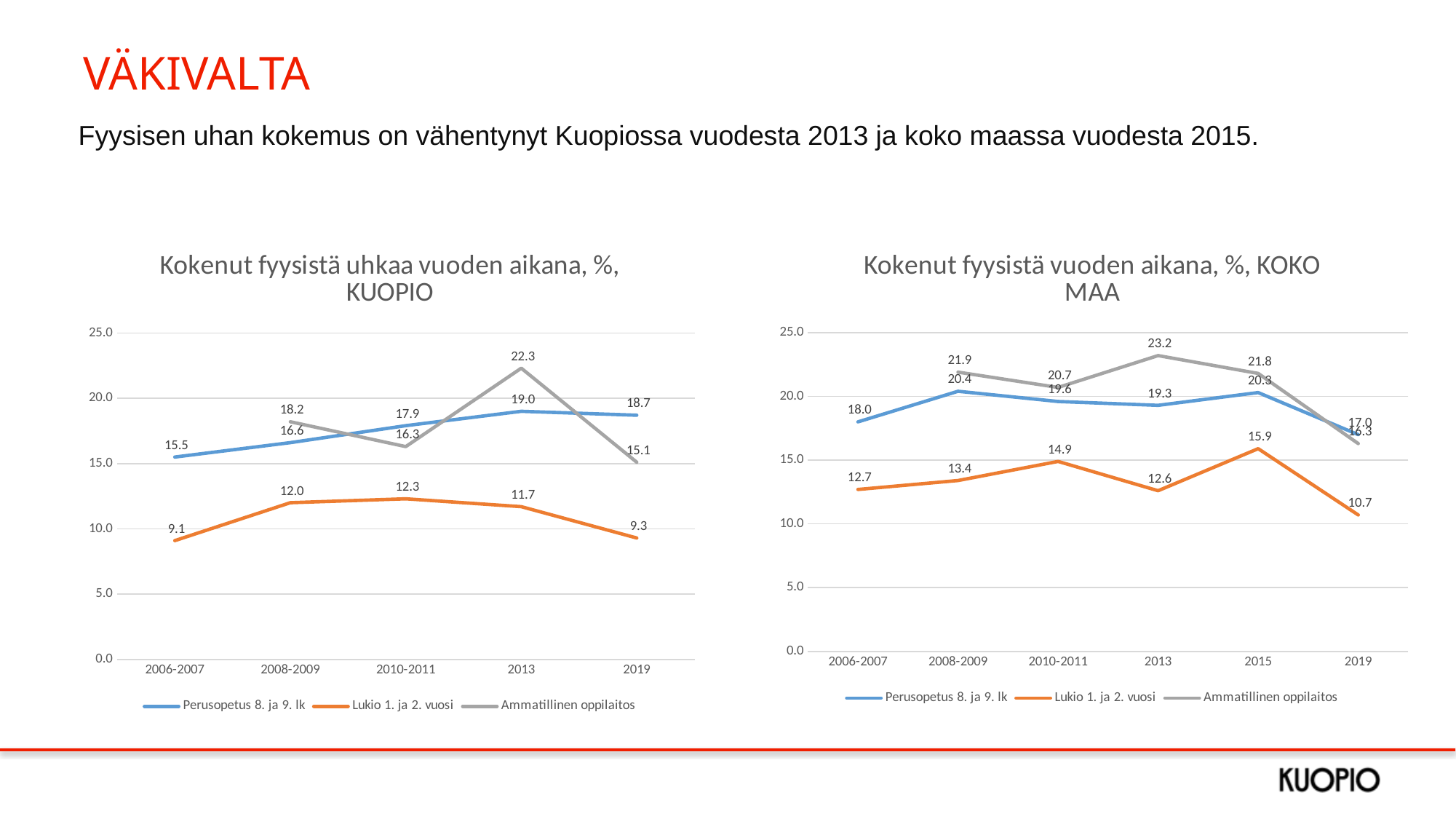
In the KUOPIO chart, what is the value for Ammatillinen oppilaitos in 2019? 15.1 In the KOKO MAA chart, what is the value for Perusopetus 8. ja 9. lk in 2015? 20.3 In the KOKO MAA chart, is the value for Lukio 1. ja 2. vuosi in 2015 greater or less than Perusopetus 8. ja 9. lk in 2015? less In the KUOPIO chart, what is the difference between Perusopetus 8. ja 9. lk and Lukio 1. ja 2. vuosi in 2019? 9.4 In the KOKO MAA chart, how many series does the legend list? 3 In the KUOPIO chart, what is the value for Lukio 1. ja 2. vuosi in 2013? 11.7 In the KUOPIO chart, in which year does Ammatillinen oppilaitos reach its highest value? 2013 What type of chart is the KOKO MAA chart? line chart In the KUOPIO chart, in which year is the Lukio 1. ja 2. vuosi value lowest? 2006-2007 In the KOKO MAA chart, which series has the highest value in 2013? Ammatillinen oppilaitos In the KUOPIO chart, how many x-axis categories are shown? 5 In the KOKO MAA chart, what is the value for Lukio 1. ja 2. vuosi in 2019? 10.7